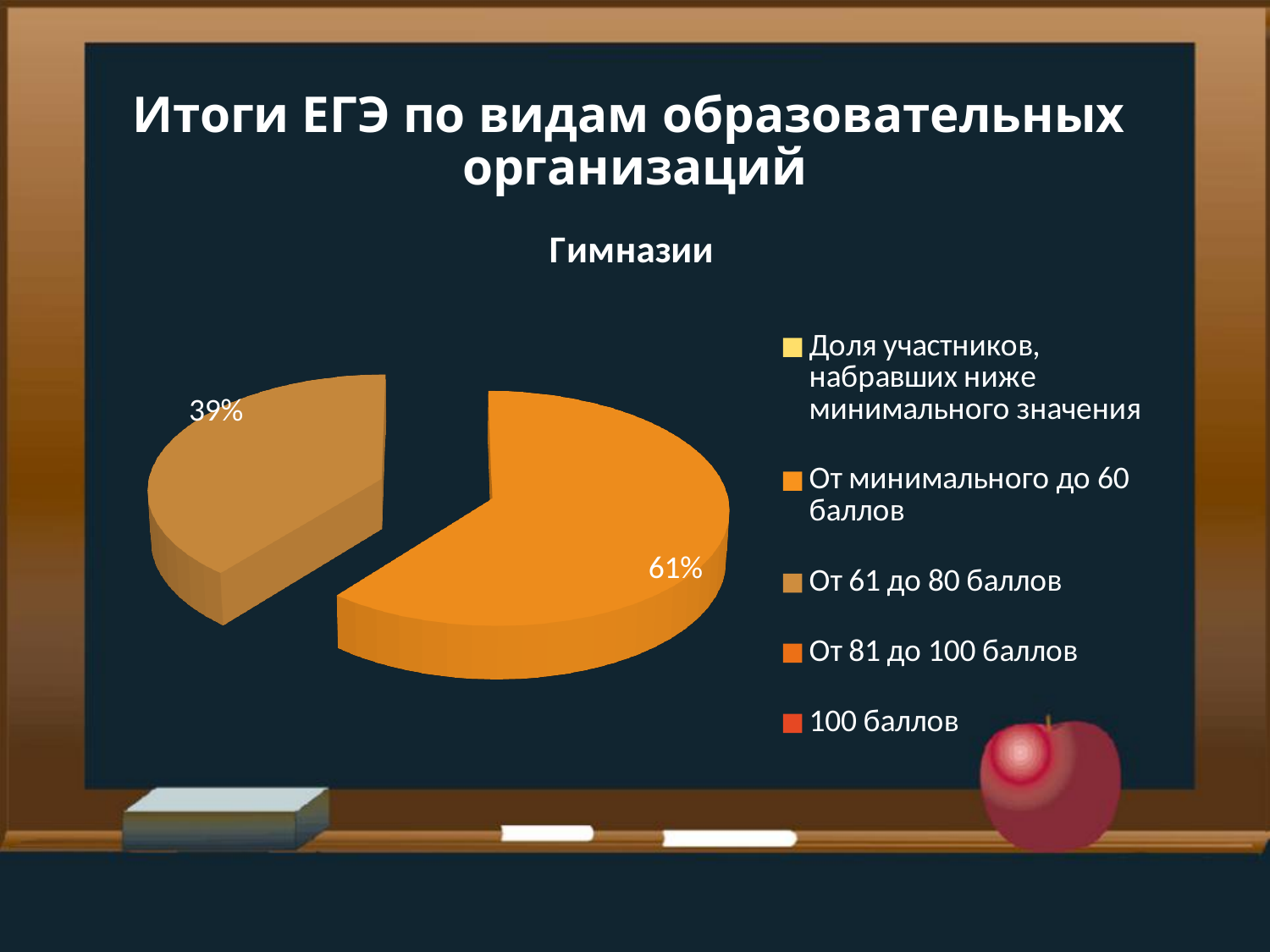
What is the title of the chart? Гимназии How many slices are visible in the pie chart? 2 What kind of chart is shown on the slide? pie chart Is the value for 'От 61 до 80 баллов' greater or less than 50%? less What share of the pie does the slice for 'От минимального до 60 баллов' represent? 61% What is the last entry listed in the chart legend? 100 баллов Which of the two visible slices is smaller? От 61 до 80 баллов What share of the pie does the slice for 'От 61 до 80 баллов' represent? 39% Which is larger: the slice for 'От минимального до 60 баллов' or the slice for 'От 61 до 80 баллов'? От минимального до 60 баллов How many entries does the chart legend list? 5 Which category has the largest slice in the pie chart? От минимального до 60 баллов What is the difference between the 61% slice and the 39% slice? 22%